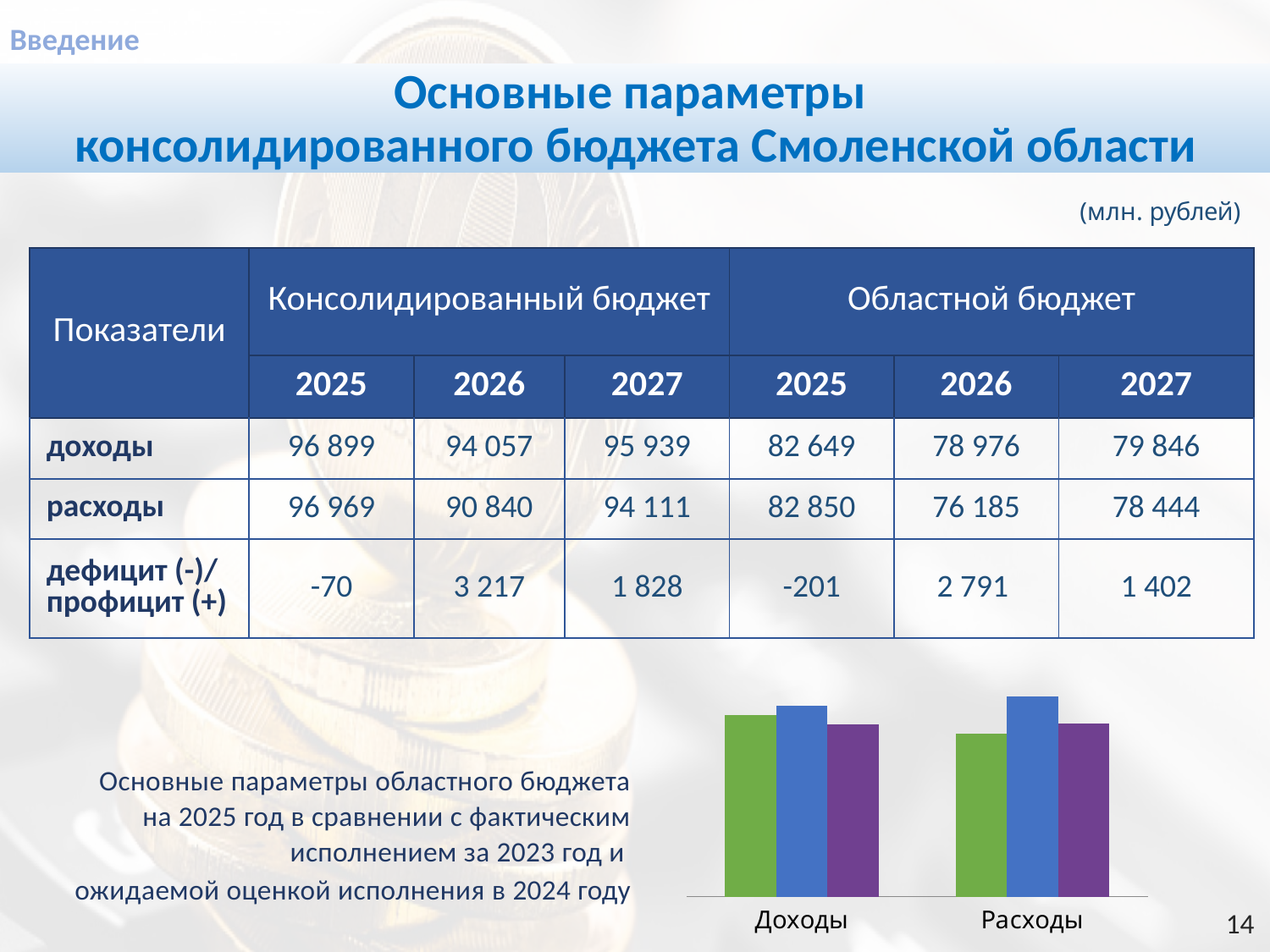
In the bar chart, which coloured bar is the shortest in the Расходы group? green How many bars are plotted in total in the bar chart? 6 Does the bar chart display a legend? No In the bar chart, which coloured bar is the tallest in the Расходы group? blue What kind of chart is shown at the bottom right of the slide? bar chart How many bars are plotted for each category in the bar chart? 3 In the Расходы group of the bar chart, which is taller, the purple bar or the green bar? purple In the bar chart, is the green bar taller for Доходы or for Расходы? Доходы What are the two category labels on the x axis of the bar chart? Доходы and Расходы In the bar chart, is the blue bar taller for Доходы or for Расходы? Расходы In the bar chart, which coloured bar is the tallest in the Доходы group? blue How many categories are shown on the x axis of the bar chart? 2